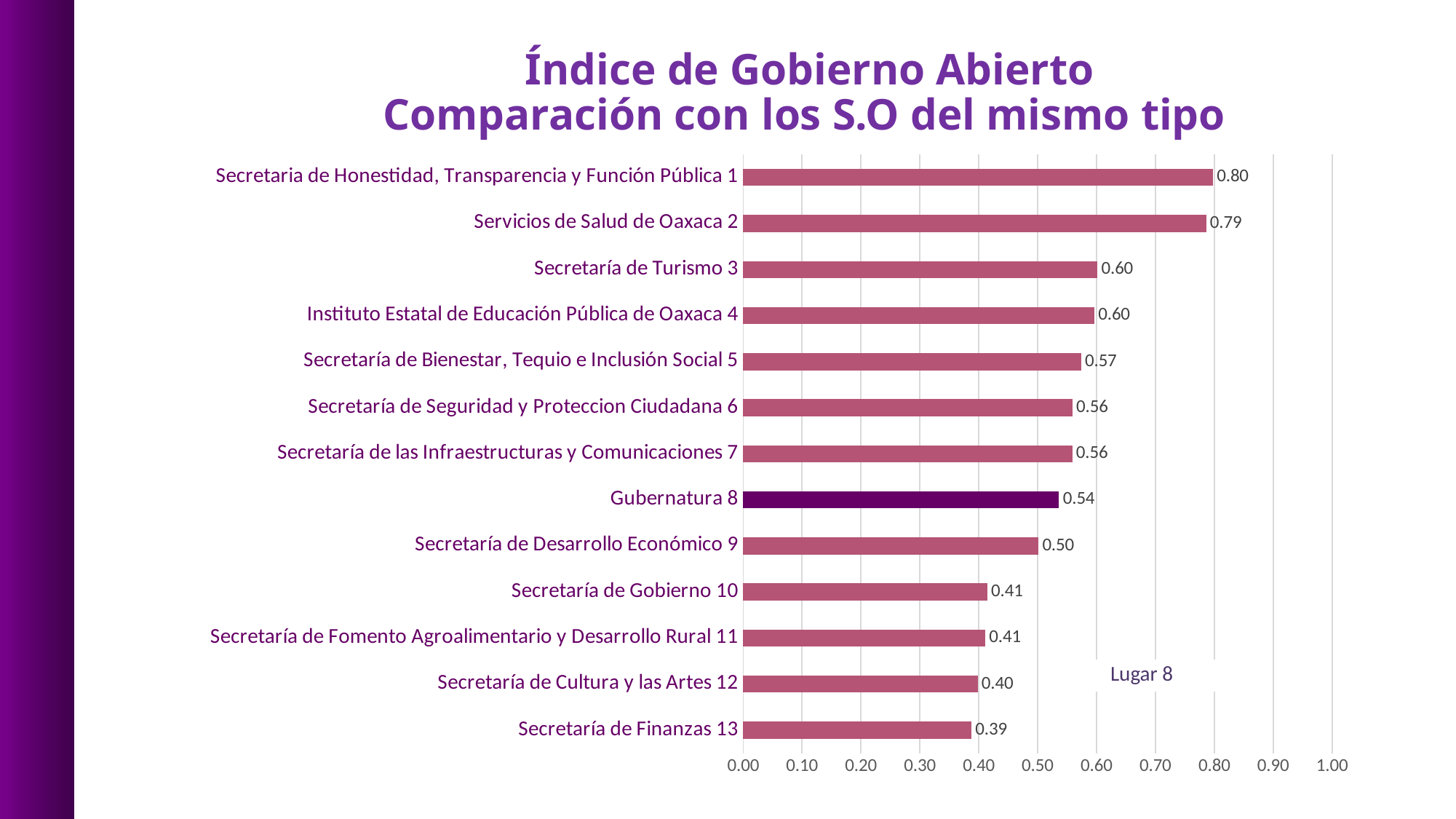
Is the value for Secretaría de Turismo 3 greater or less than 0.50? greater What is the value for Servicios de Salud de Oaxaca 2? 0.79 How many categories are shown in the chart? 13 Which category has the lowest value? Secretaría de Finanzas 13 What is the value for Secretaría de Finanzas 13? 0.39 What kind of chart is shown on the slide? bar chart Which is larger, the value for Secretaría de Desarrollo Económico 9 or the value for Secretaría de Gobierno 10? Secretaría de Desarrollo Económico 9 What is the difference between the values for Secretaria de Honestidad, Transparencia y Función Pública 1 and Gubernatura 8? 0.26 What is the title of the chart? Índice de Gobierno Abierto Comparación con los S.O del mismo tipo Which bar is shown in a darker colour than the others? Gubernatura 8 What is the value for Gubernatura 8? 0.54 Which category has the highest value? Secretaria de Honestidad, Transparencia y Función Pública 1